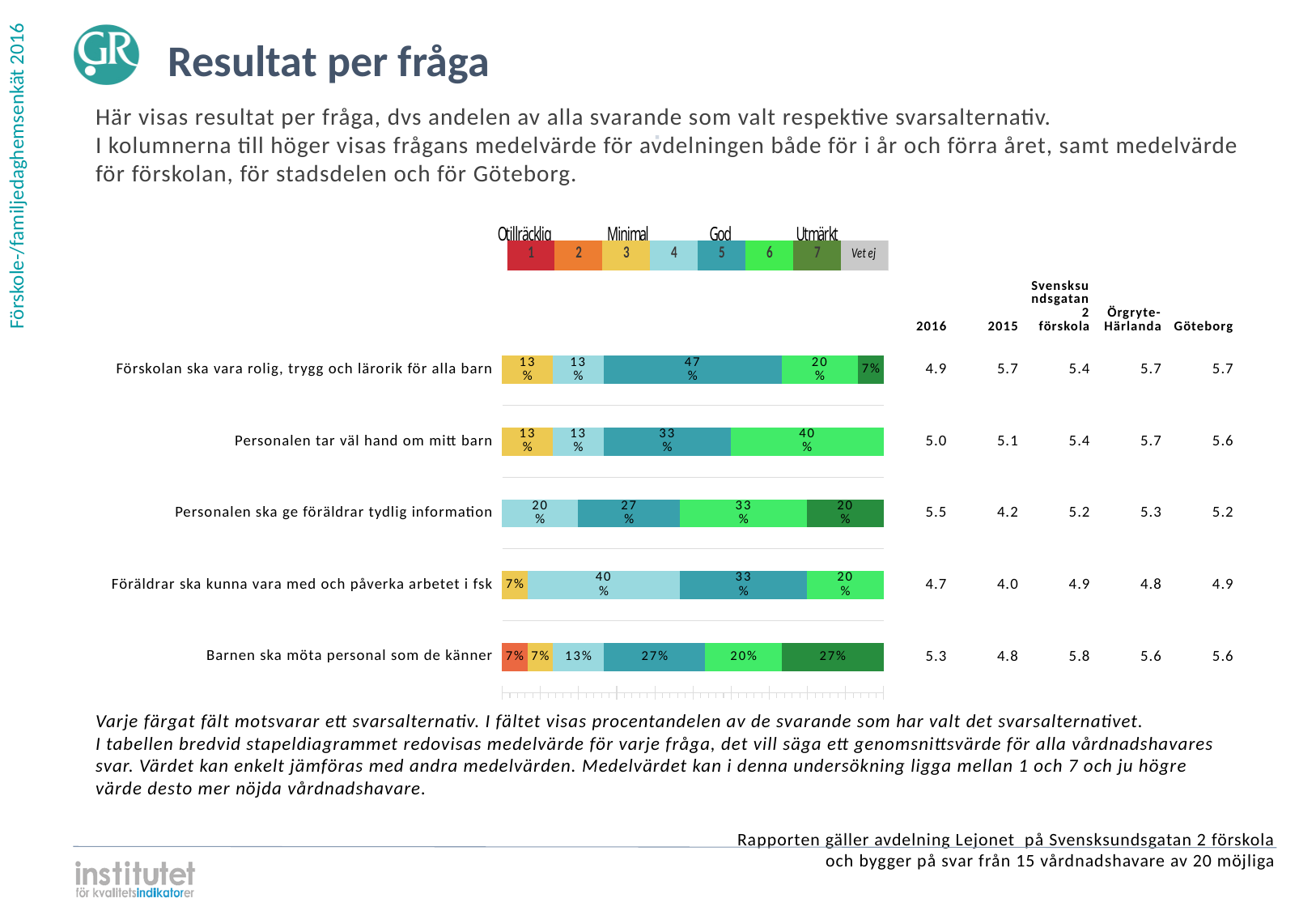
What percentage of respondents chose answer 6 for "Personalen tar väl hand om mitt barn"? 40% What percentage of respondents chose answer 5 for "Förskolan ska vara rolig, trygg och lärorik för alla barn"? 47% What kind of chart is shown on the slide? Stacked bar chart Which answer alternative is shown in red in the legend? 1 What is the difference between the share for answer 6 and the share for answer 7 in "Personalen ska ge föräldrar tydlig information"? 13% What percentage of respondents chose answer 7 for "Barnen ska möta personal som de känner"? 27% What is the combined share of answers 6 and 7 for "Barnen ska möta personal som de känner"? 47% Which answer alternative has the largest share for "Föräldrar ska kunna vara med och påverka arbetet i fsk"? 4 For "Förskolan ska vara rolig, trygg och lärorik för alla barn", which is larger: the share for answer 5 or the share for answer 6? Answer 5 What is the 2016 mean value for "Personalen ska ge föräldrar tydlig information"? 5.5 How many questions (categories) are plotted in the bar chart? 5 What label does the legend give to the grey box at the right end of the scale? Vet ej